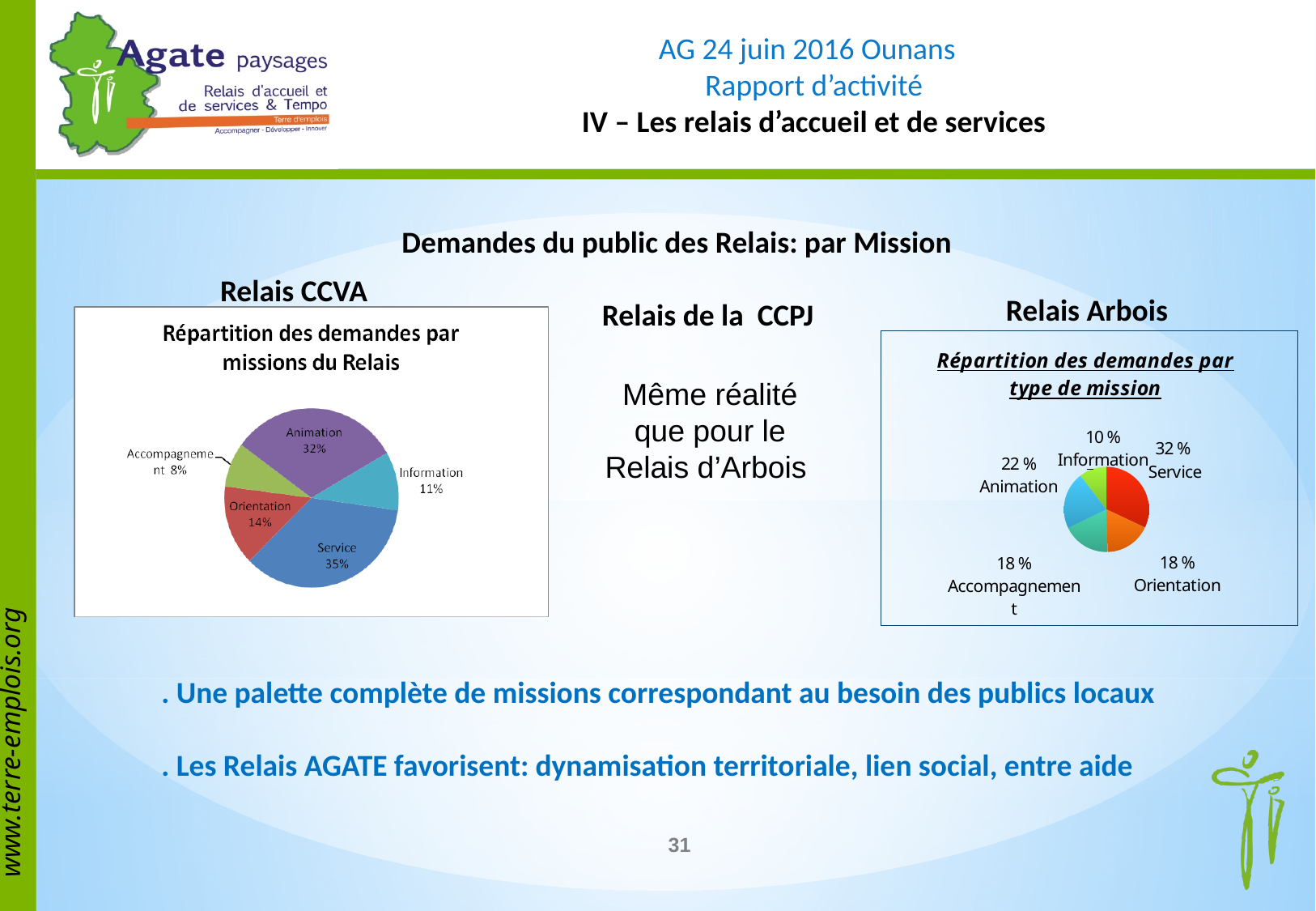
In the Relais CCVA chart, which mission has the largest share? Service What is the title of the Relais CCVA chart? Répartition des demandes par missions du Relais In the Relais CCVA chart, what share of demands is for Accompagnement? 8% In the Relais Arbois chart, which type of mission has the smallest share? Information In the Relais CCVA chart, what share of demands is for Service? 35% In the Relais CCVA chart, which mission has the smallest share? Accompagnement In the Relais CCVA chart, what is the difference between the Animation and Information shares? 21% In the Relais Arbois chart, what share of demands is for Animation? 22 % In the Relais CCVA chart, how many missions are shown? 5 In the Relais Arbois chart, which is larger, the share for Animation or the share for Orientation? Animation What kind of chart is used for Relais Arbois? Pie chart In the Relais Arbois chart, what share of demands is for Service? 32 %